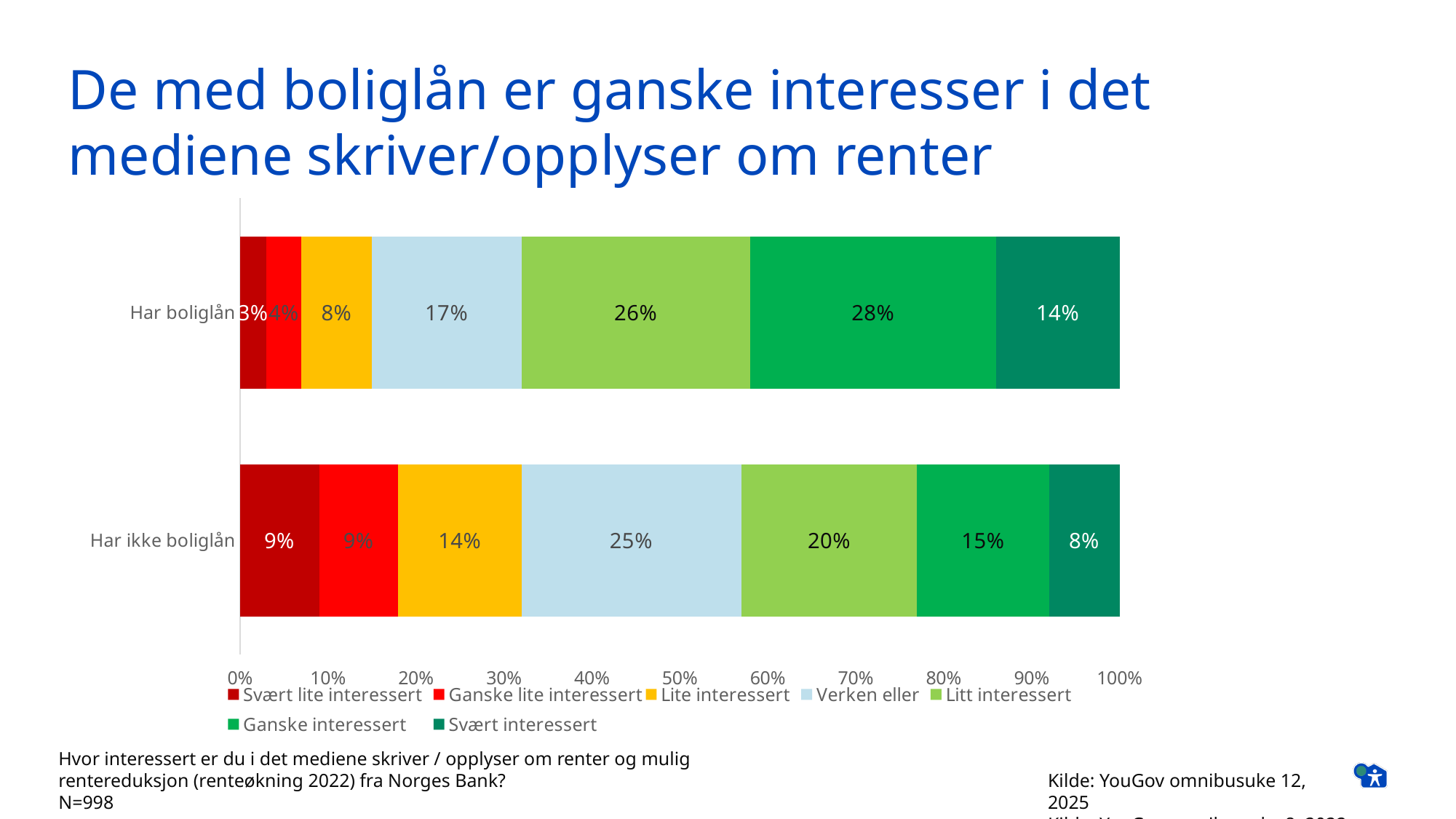
What is the difference between the 'Ganske interessert' values for 'Har boliglån' and 'Har ikke boliglån'? 13 percentage points How many categories are plotted on the y axis? 2 What is the value for 'Ganske interessert' in the 'Har boliglån' bar? 28% What is the total of the 'Har ikke boliglån' stacked bar? 100% Which segment is the largest in the 'Har boliglån' bar? Ganske interessert Which segment is the smallest in the 'Har ikke boliglån' bar? Svært interessert What kind of chart is shown on the slide? Stacked bar chart Which category has the larger value for 'Lite interessert', 'Har boliglån' or 'Har ikke boliglån'? Har ikke boliglån What is the value for 'Verken eller' in the 'Har ikke boliglån' bar? 25% What is the value for 'Svært interessert' in the 'Har boliglån' bar? 14% How many series does the legend list? 7 What is the value for 'Svært lite interessert' in the 'Har ikke boliglån' bar? 9%